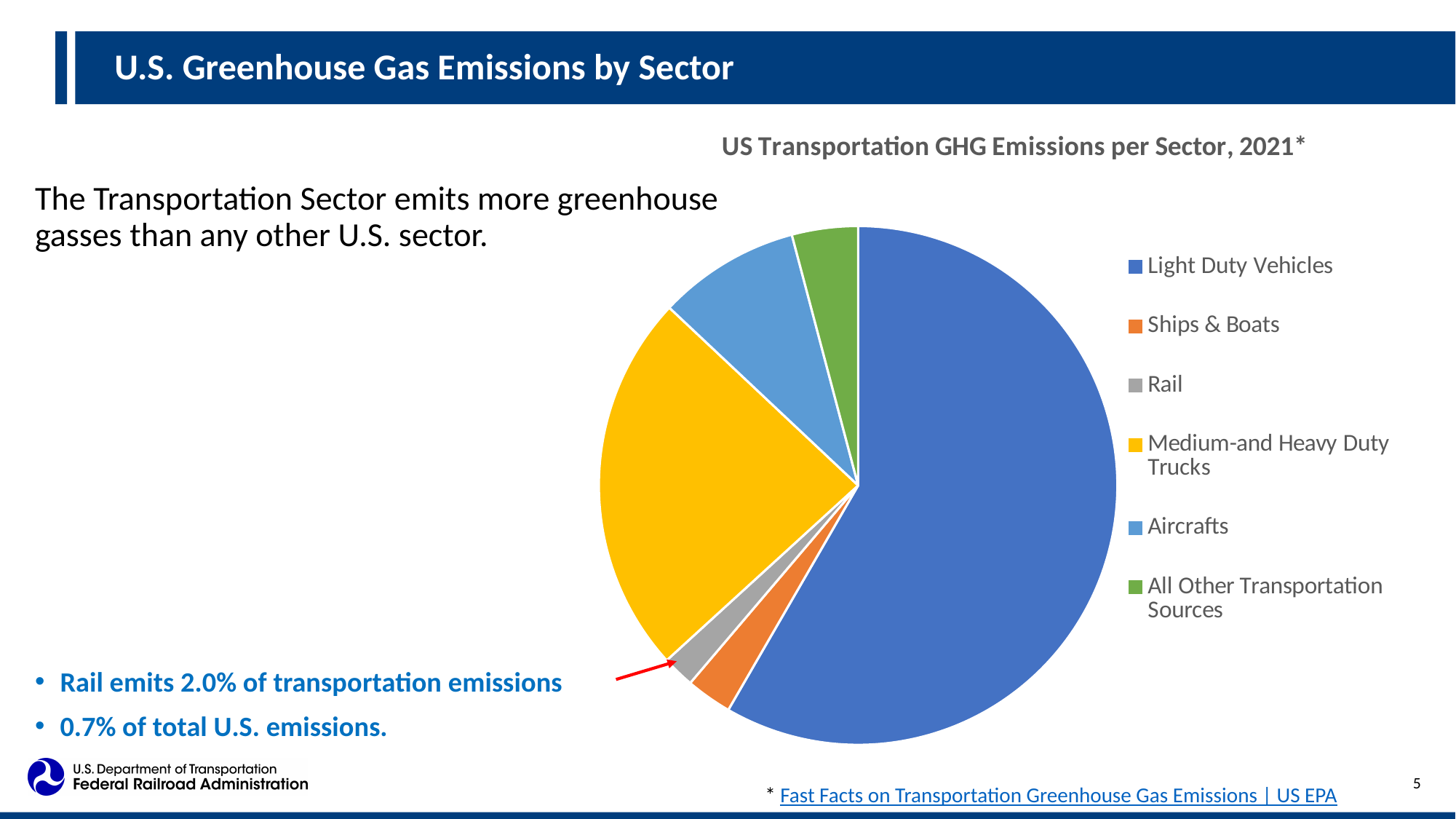
Which category has the smallest slice of the pie? Rail Which category has the largest slice of the pie? Light Duty Vehicles What is the title of the chart? US Transportation GHG Emissions per Sector, 2021* What kind of chart is shown on the slide? pie chart Which slice is larger, Medium-and Heavy Duty Trucks or Aircrafts? Medium-and Heavy Duty Trucks Which slice is larger, Aircrafts or All Other Transportation Sources? Aircrafts How many categories does the pie chart show? 6 What share of transportation emissions does Rail account for, according to the slide? 2.0% Which slice is larger, Light Duty Vehicles or Medium-and Heavy Duty Trucks? Light Duty Vehicles What colour is the Rail slice in the pie chart? gray